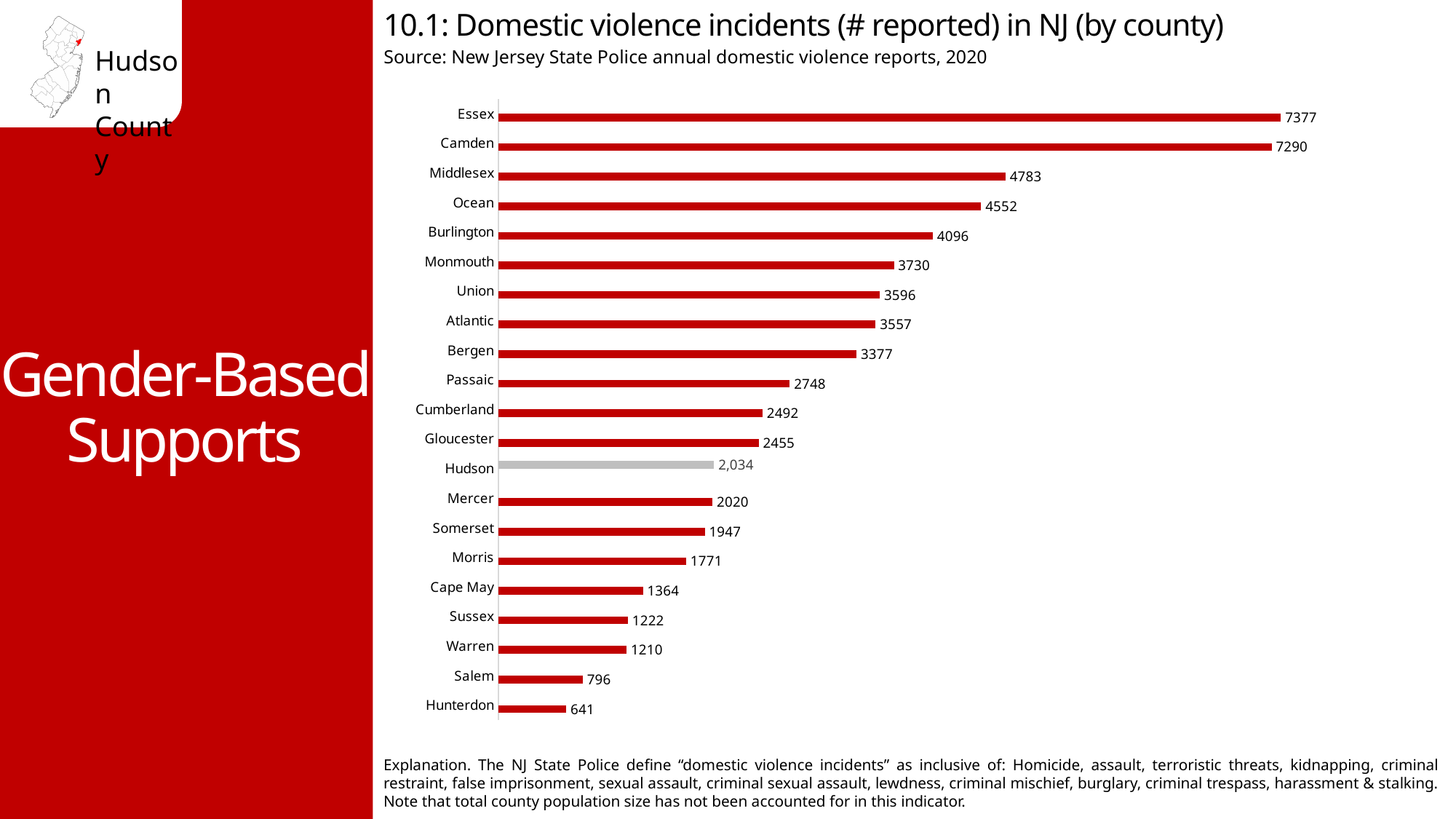
What is the number of reported domestic violence incidents for Essex County? 7377 Which county has the highest number of reported domestic violence incidents? Essex What type of chart is used to show domestic violence incidents by county? Bar chart Which county has more reported domestic violence incidents, Salem or Warren? Warren What is the difference in reported domestic violence incidents between Essex and Camden? 87 Which county has the lowest number of reported domestic violence incidents? Hunterdon What is the number of reported domestic violence incidents for Hudson County? 2,034 Which county has more reported domestic violence incidents, Monmouth or Bergen? Monmouth What is the number of reported domestic violence incidents for Cape May County? 1364 What is the difference in reported domestic violence incidents between Middlesex and Ocean? 231 How many counties are shown in the chart? 21 Which county's bar is shown in grey rather than red? Hudson